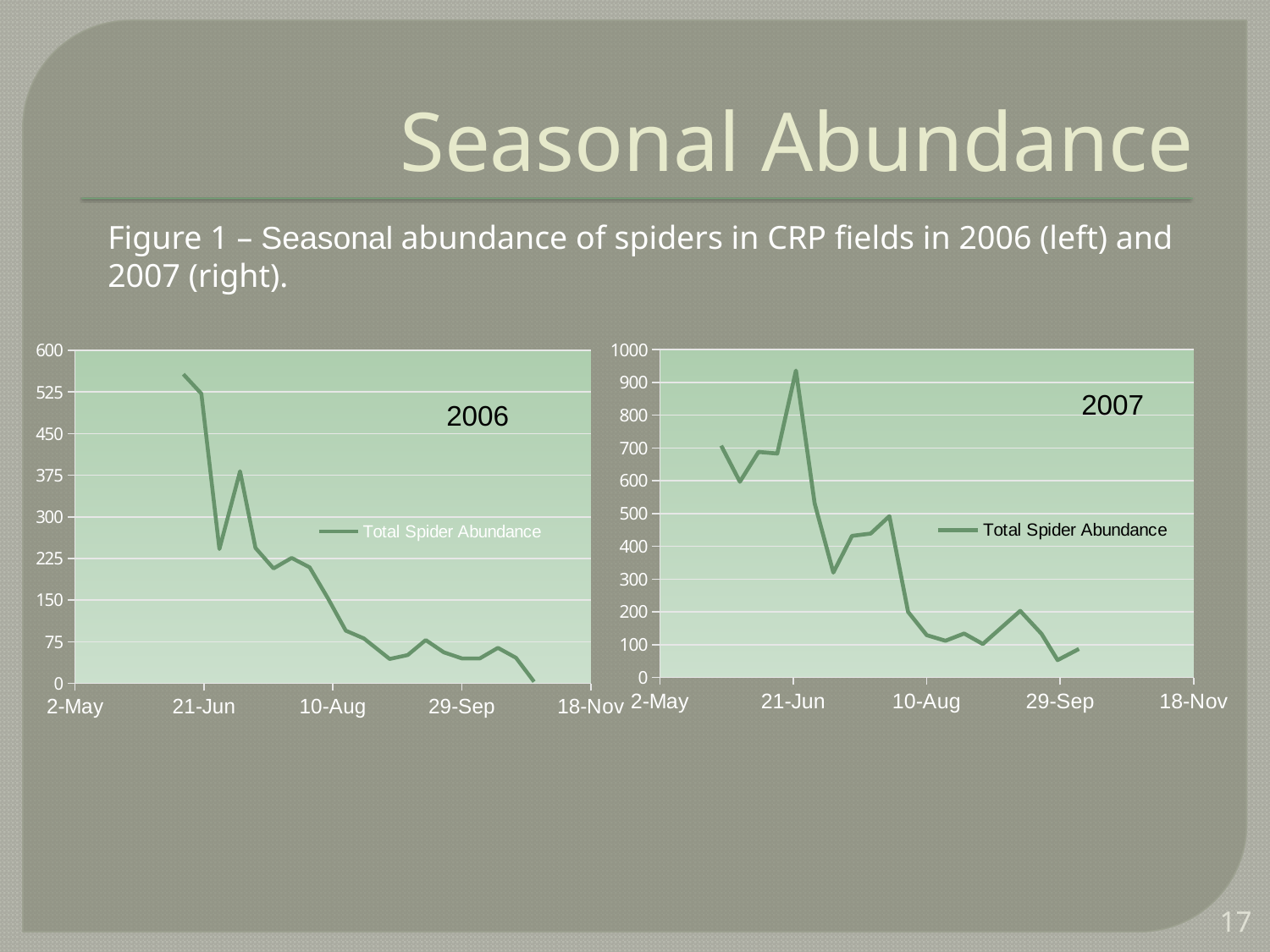
In the 2007 chart, is the last plotted value (early October) greater or less than 200? less What kind of chart is the 2007 chart on the right? line chart Which chart has the higher peak value, the 2006 chart or the 2007 chart? 2007 In the 2006 chart, is the last plotted value (near the end of October) greater or less than 75? less What is the name of the series shown in the legend of the 2007 chart? Total Spider Abundance How many series does the legend of the 2006 chart list? 1 What is the maximum value shown on the y axis of the 2007 chart? 1000 In the 2007 chart, is the peak value near 21-Jun greater or less than 800? greater In the 2006 chart, do the values generally rise or fall from May to November? fall In the 2007 chart, do the values generally rise or fall from late June to November? fall What kind of chart is the 2006 chart on the left? line chart